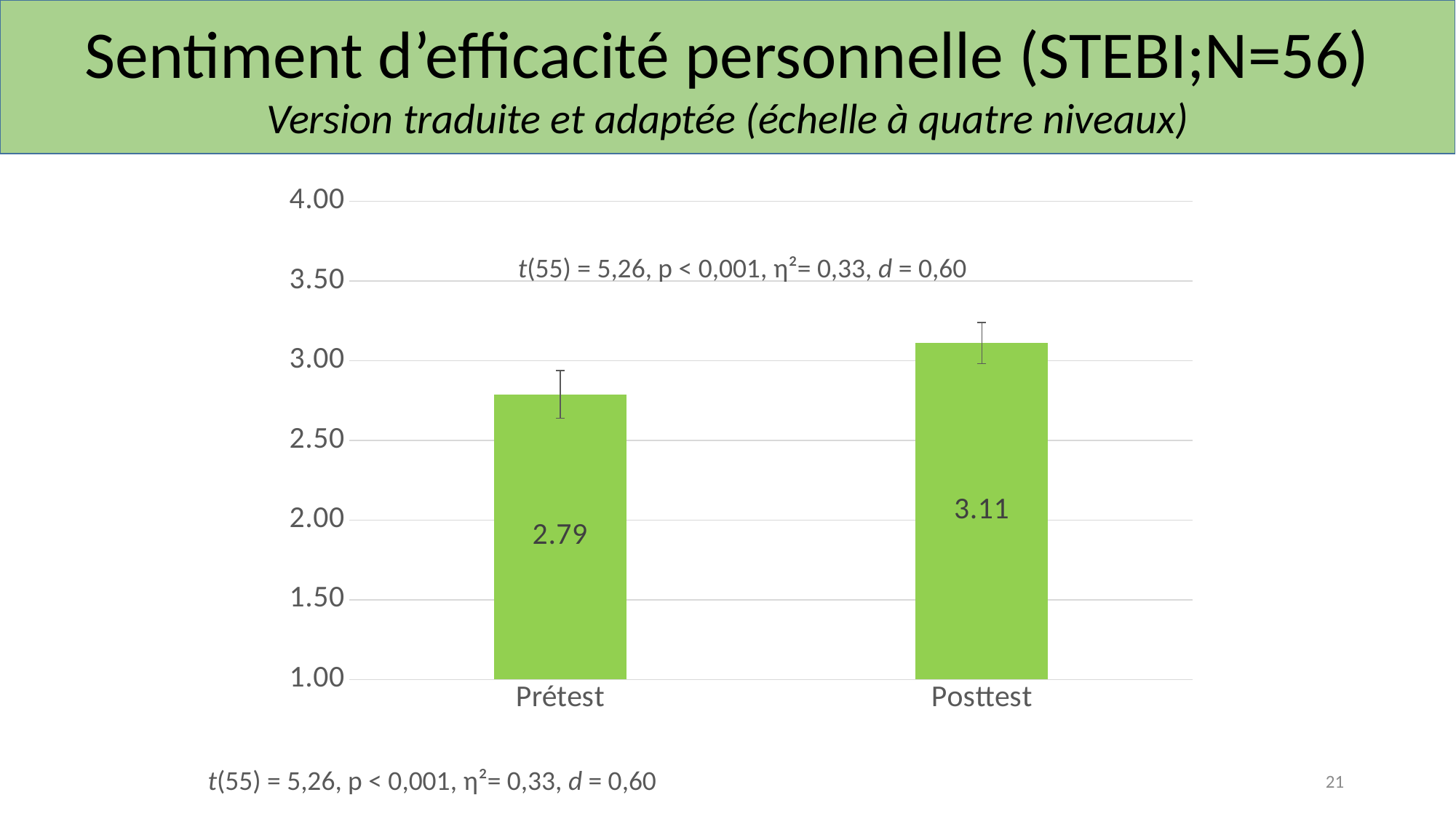
Which is larger, the value for Prétest or the value for Posttest? Posttest What is the value for Prétest? 2.79 Is the value for Prétest greater or less than 3.00? less How many categories are shown on the x axis? 2 Which category has the highest value? Posttest Which category has the lowest value? Prétest Is the value for Posttest greater or less than 3.00? greater Do the values rise or fall from Prétest to Posttest? rise What is the highest value shown on the y axis? 4.00 What kind of chart is shown on the slide? bar chart What is the difference between the Posttest and Prétest values? 0.32 What is the value for Posttest? 3.11